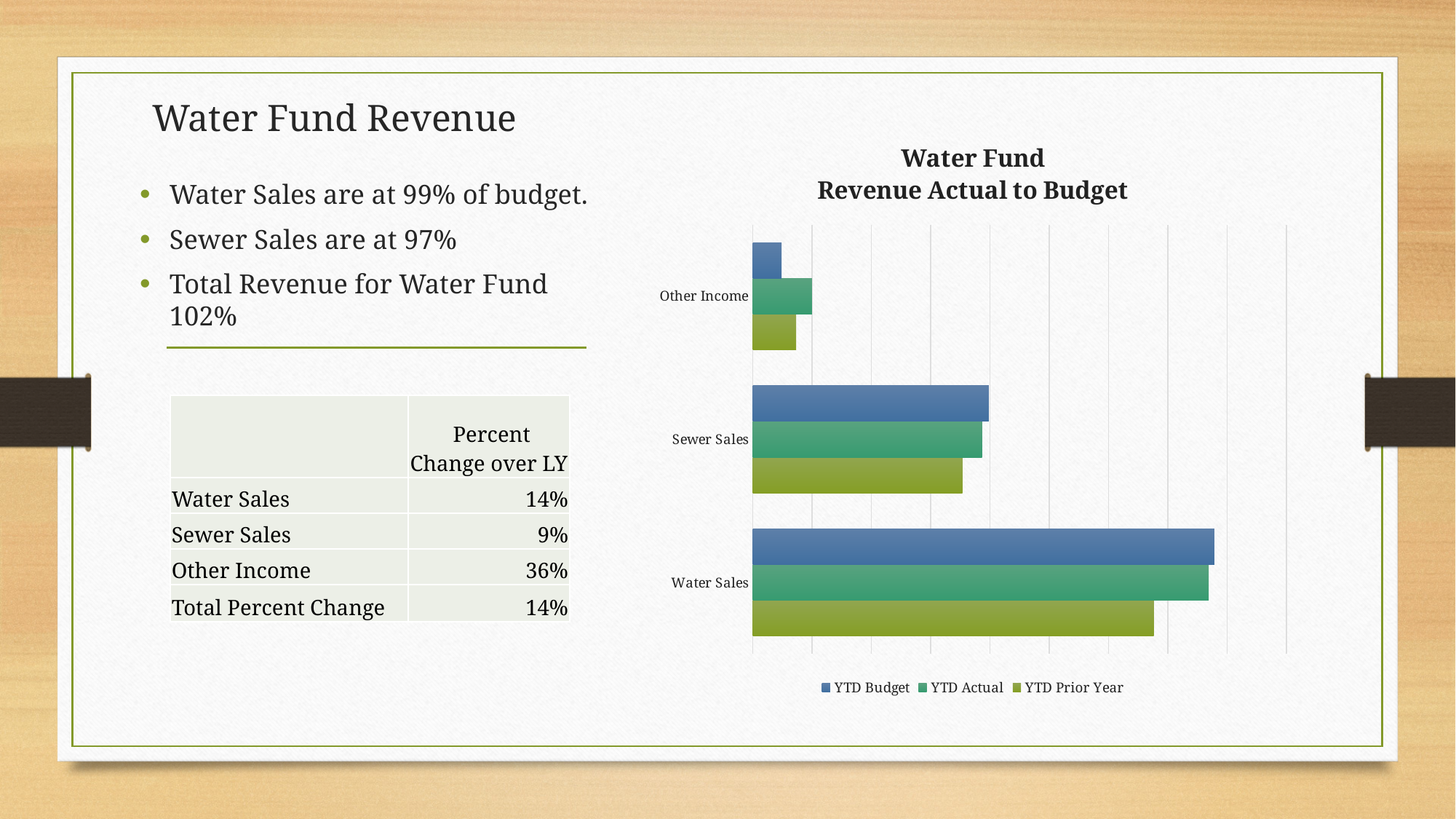
What kind of chart is shown on the slide? Bar chart For Other Income, which is larger: YTD Budget or YTD Actual? YTD Actual How many series does the chart legend list? 3 Which category has the highest YTD Budget value? Water Sales For Water Sales, which is larger: YTD Actual or YTD Prior Year? YTD Actual Which category has the highest YTD Prior Year value? Water Sales Which is larger: the YTD Budget for Sewer Sales or the YTD Budget for Other Income? Sewer Sales Which category has the lowest YTD Prior Year value? Other Income What is the title of the chart? Water Fund Revenue Actual to Budget Which series are listed in the chart legend? YTD Budget, YTD Actual, YTD Prior Year How many categories are shown on the chart? 3 Which category has the lowest YTD Actual value? Other Income